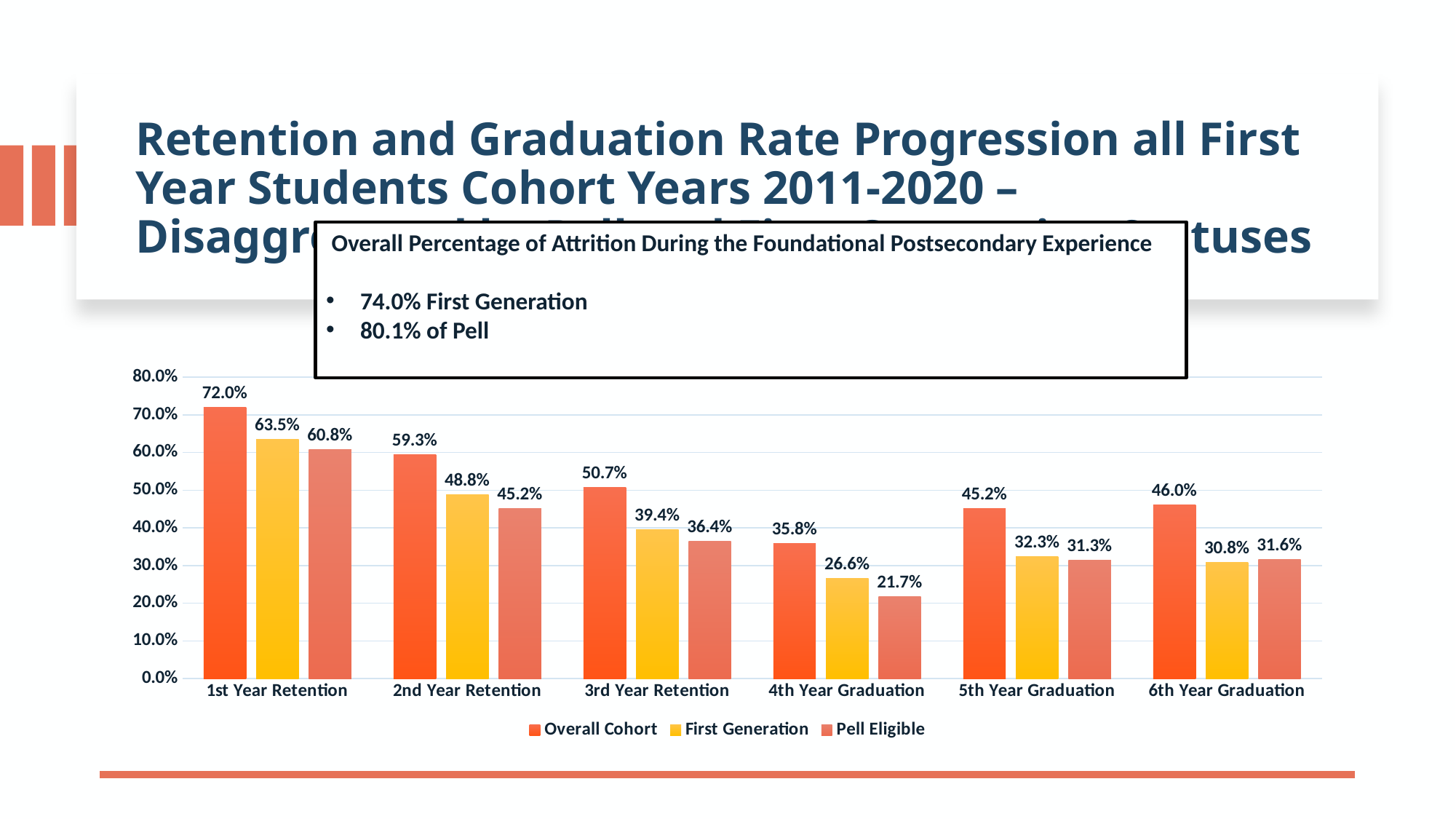
Which series is shown in yellow in the legend? First Generation What is the Pell Eligible value for 4th Year Graduation? 21.7% Which category has the lowest Pell Eligible value? 4th Year Graduation Which category has the highest First Generation value? 1st Year Retention Which is larger for 6th Year Graduation: First Generation or Pell Eligible? Pell Eligible How many series does the legend list? 3 How many categories are shown on the x axis? 6 What is the difference between the Overall Cohort and First Generation values for 2nd Year Retention? 10.5% Do the Overall Cohort values rise or fall from 1st Year Retention to 4th Year Graduation? Fall What kind of chart is shown on the slide? Bar chart What is the Overall Cohort value for 1st Year Retention? 72.0% What is the First Generation value for 3rd Year Retention? 39.4%